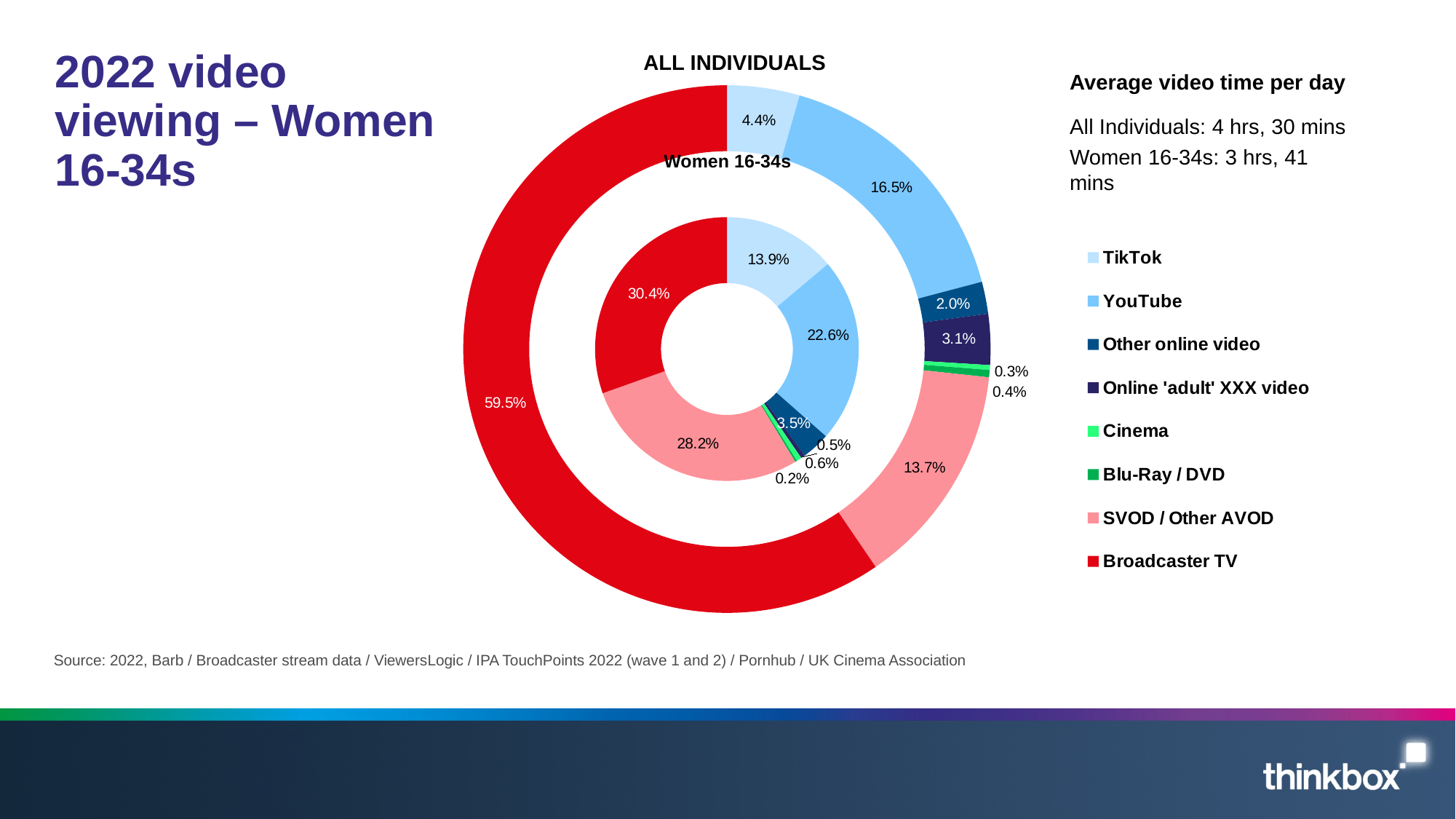
Which is larger: the YouTube share for Women 16-34s or the YouTube share for All Individuals? Women 16-34s According to the text on the slide, what is the average video time per day for Women 16-34s? 3 hrs, 41 mins What is the difference between the TikTok share for Women 16-34s (13.9%) and for All Individuals (4.4%)? 9.5 percentage points In the Women 16-34s (inner) ring, what share is Broadcaster TV? 30.4% How many series does the legend list? 8 In the ALL INDIVIDUALS (outer) ring, what share is YouTube? 16.5% In the Women 16-34s (inner) ring, what share is TikTok? 13.9% In the ALL INDIVIDUALS (outer) ring, which category has the smallest share? Cinema In the Women 16-34s (inner) ring, what share is SVOD / Other AVOD? 28.2% In the ALL INDIVIDUALS (outer) ring, which category has the largest share? Broadcaster TV What type of chart is shown on the slide? Doughnut chart In the ALL INDIVIDUALS (outer) ring, what share is Broadcaster TV? 59.5%